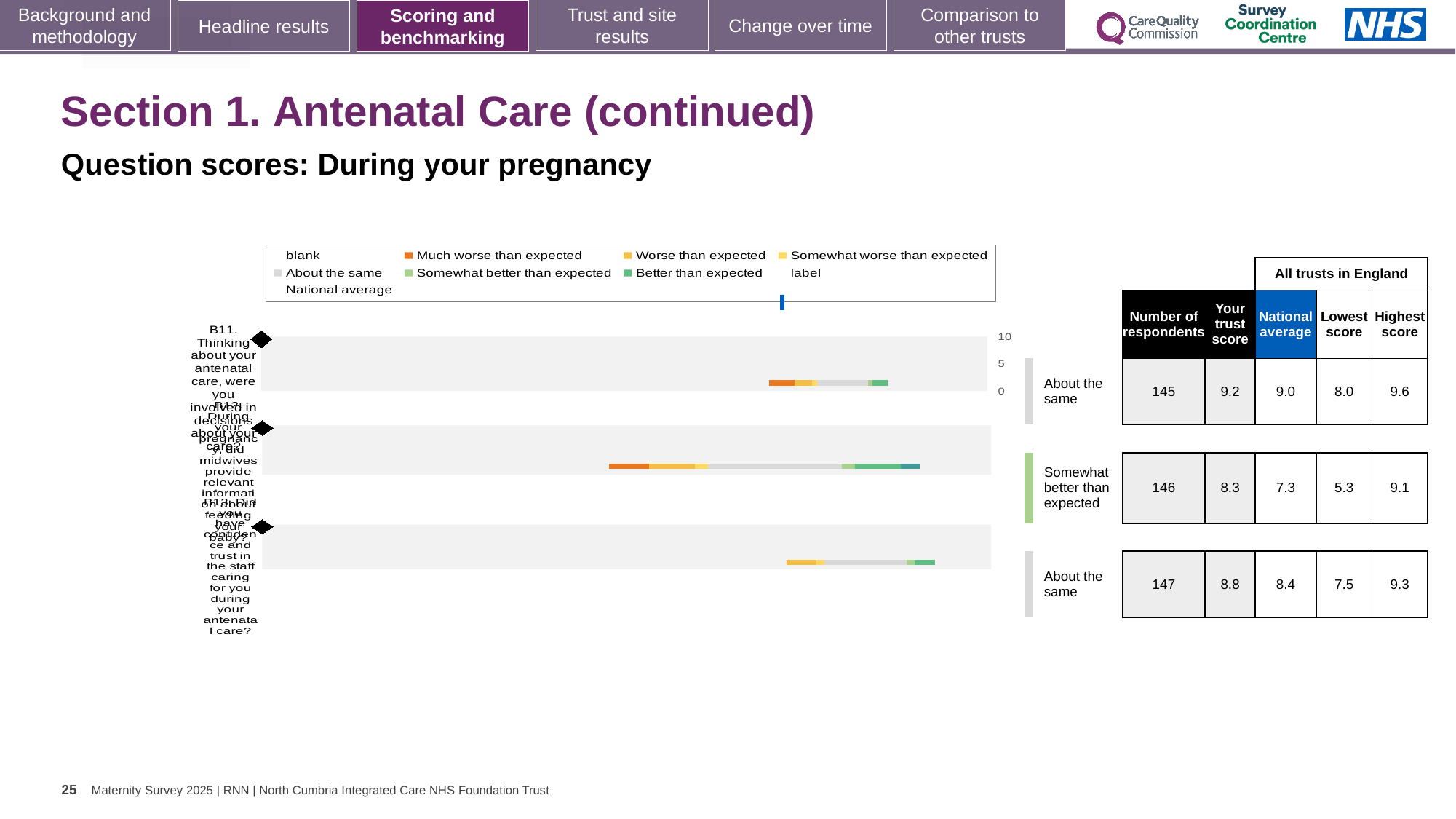
What colour does the legend use for 'Better than expected'? green For question B13, which is larger: the trust score or the national average? the trust score For question B11, what is the difference between the trust score (9.2) and the national average (9.0)? 0.2 How many entries does the chart legend list? 9 Which of the three questions has the lowest national average in the table? B12 Which of the three questions has the highest 'Your trust score' in the table? B11 What kind of chart is shown on the slide? bar chart What colour does the legend use for 'Much worse than expected'? orange In the table beside the chart, what is the 'Your trust score' for question B11 (involved in decisions about your care)? 9.2 In the table beside the chart, what is the highest score across all trusts in England for question B13 (confidence and trust in the staff)? 9.3 How many questions (categories) are plotted in the chart? 3 In the table beside the chart, how many respondents answered question B12 (midwives provide relevant information about feeding your baby)? 146